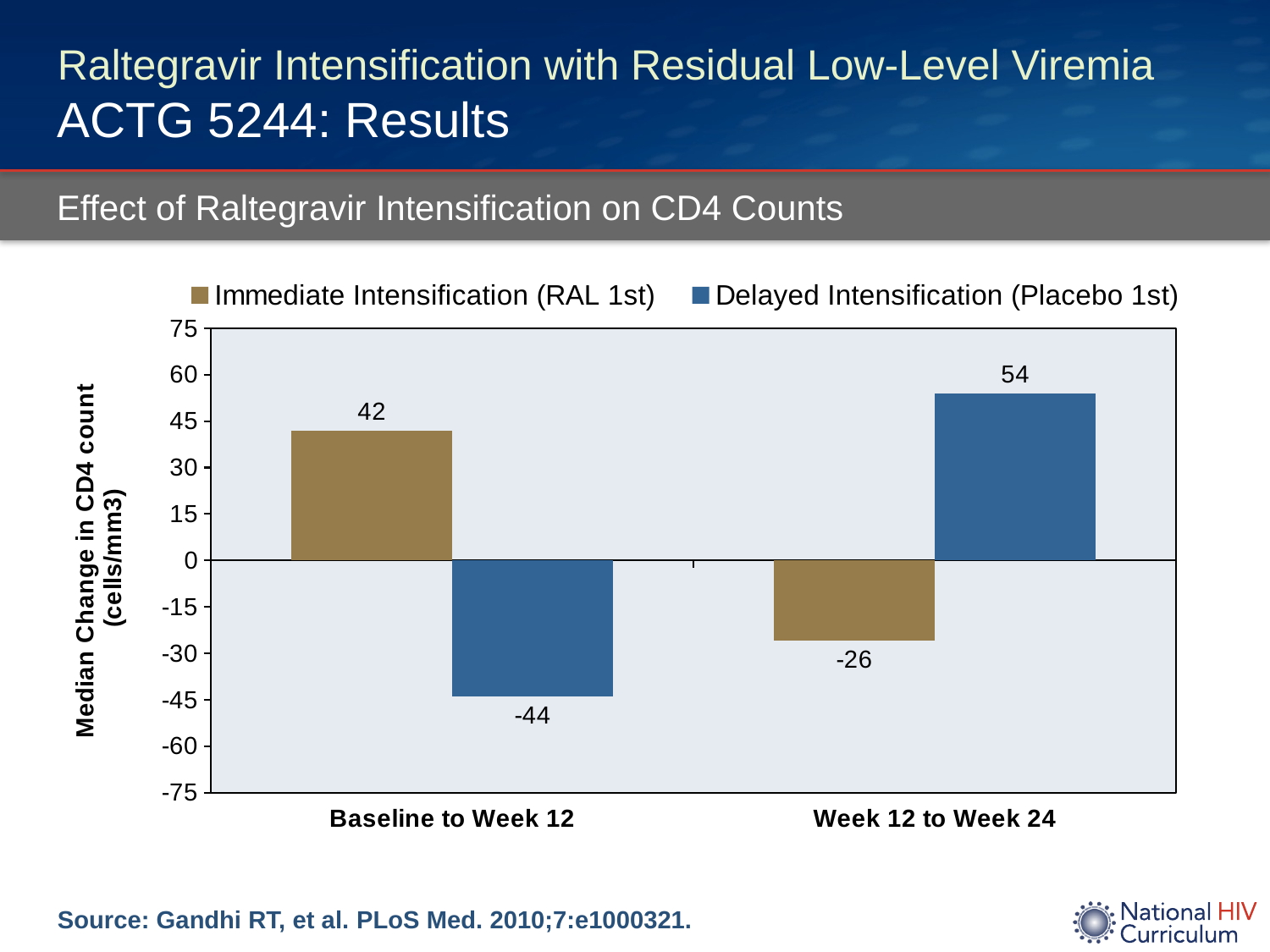
What kind of chart is shown on the slide? Bar chart Which bar shows the highest median change in CD4 count? Delayed Intensification (Placebo 1st), Week 12 to Week 24 How many series does the legend list? 2 What is the median change in CD4 count for Delayed Intensification (Placebo 1st) from Baseline to Week 12? -44 What is the median change in CD4 count for Immediate Intensification (RAL 1st) from Baseline to Week 12? 42 What is the y-axis label of the chart? Median Change in CD4 count (cells/mm3) From Baseline to Week 12, which group has the larger median change in CD4 count, Immediate Intensification or Delayed Intensification? Immediate Intensification (RAL 1st) What is the median change in CD4 count for Delayed Intensification (Placebo 1st) from Week 12 to Week 24? 54 What is the difference between the Delayed Intensification value from Week 12 to Week 24 and the Immediate Intensification value from Baseline to Week 12? 12 What is the median change in CD4 count for Immediate Intensification (RAL 1st) from Week 12 to Week 24? -26 Which bar shows the lowest median change in CD4 count? Delayed Intensification (Placebo 1st), Baseline to Week 12 How many time periods are shown on the x axis? 2